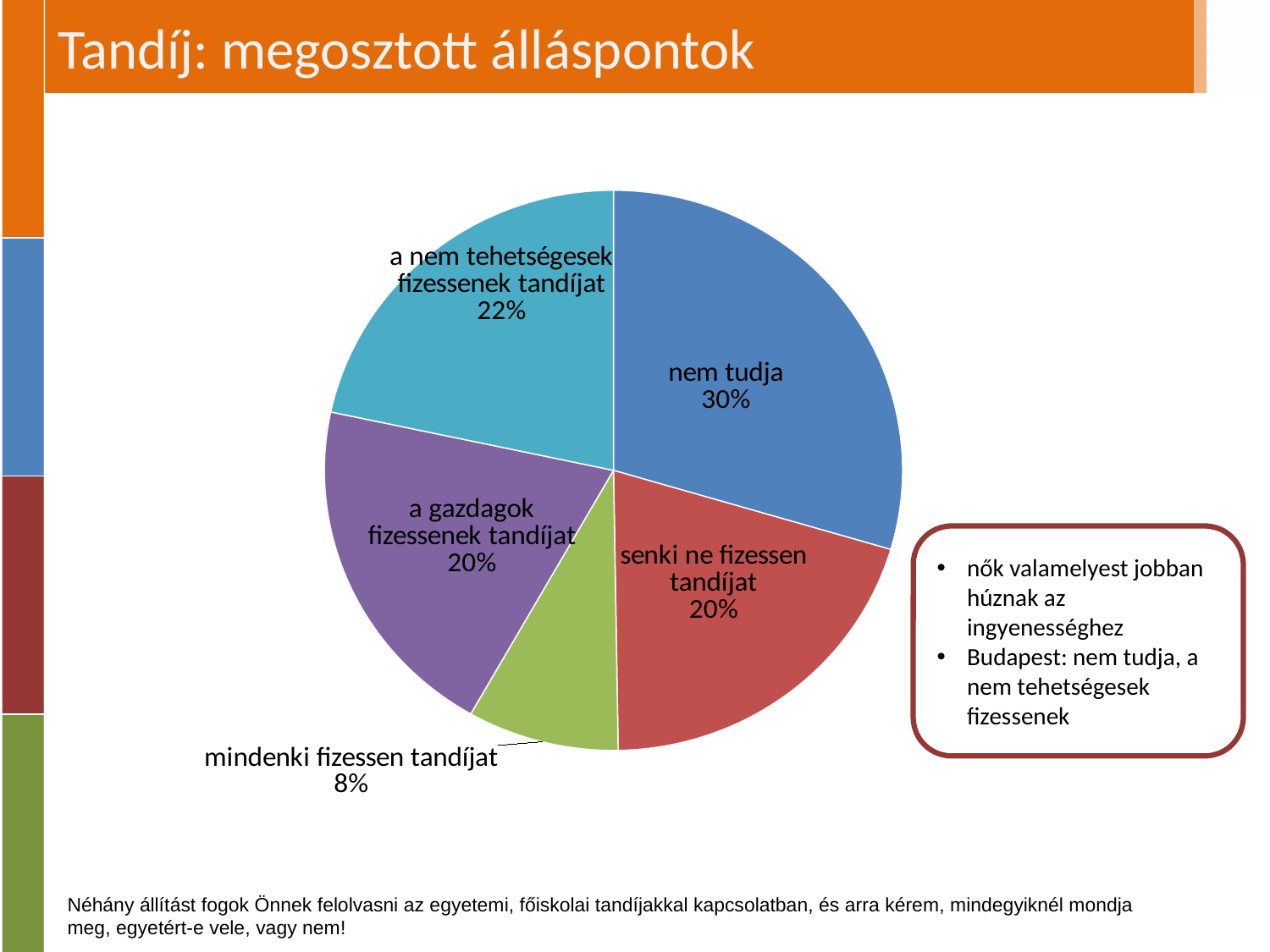
What is the value for 'a nem tehetségesek fizessenek tandíjat'? 22% What is the value for 'mindenki fizessen tandíjat'? 8% How many slices does the pie chart have? 5 What is the value for 'a gazdagok fizessenek tandíjat'? 20% What kind of chart is shown on the slide? pie chart What is the difference between 'a nem tehetségesek fizessenek tandíjat' and 'a gazdagok fizessenek tandíjat'? 2% Which category has the smallest slice? mindenki fizessen tandíjat Which is larger, 'a nem tehetségesek fizessenek tandíjat' or 'senki ne fizessen tandíjat'? a nem tehetségesek fizessenek tandíjat What is the title of the slide containing the chart? Tandíj: megosztott álláspontok What share of the pie does 'nem tudja' have? 30% What is the difference between 'nem tudja' and 'mindenki fizessen tandíjat'? 22% Which category has the largest slice? nem tudja